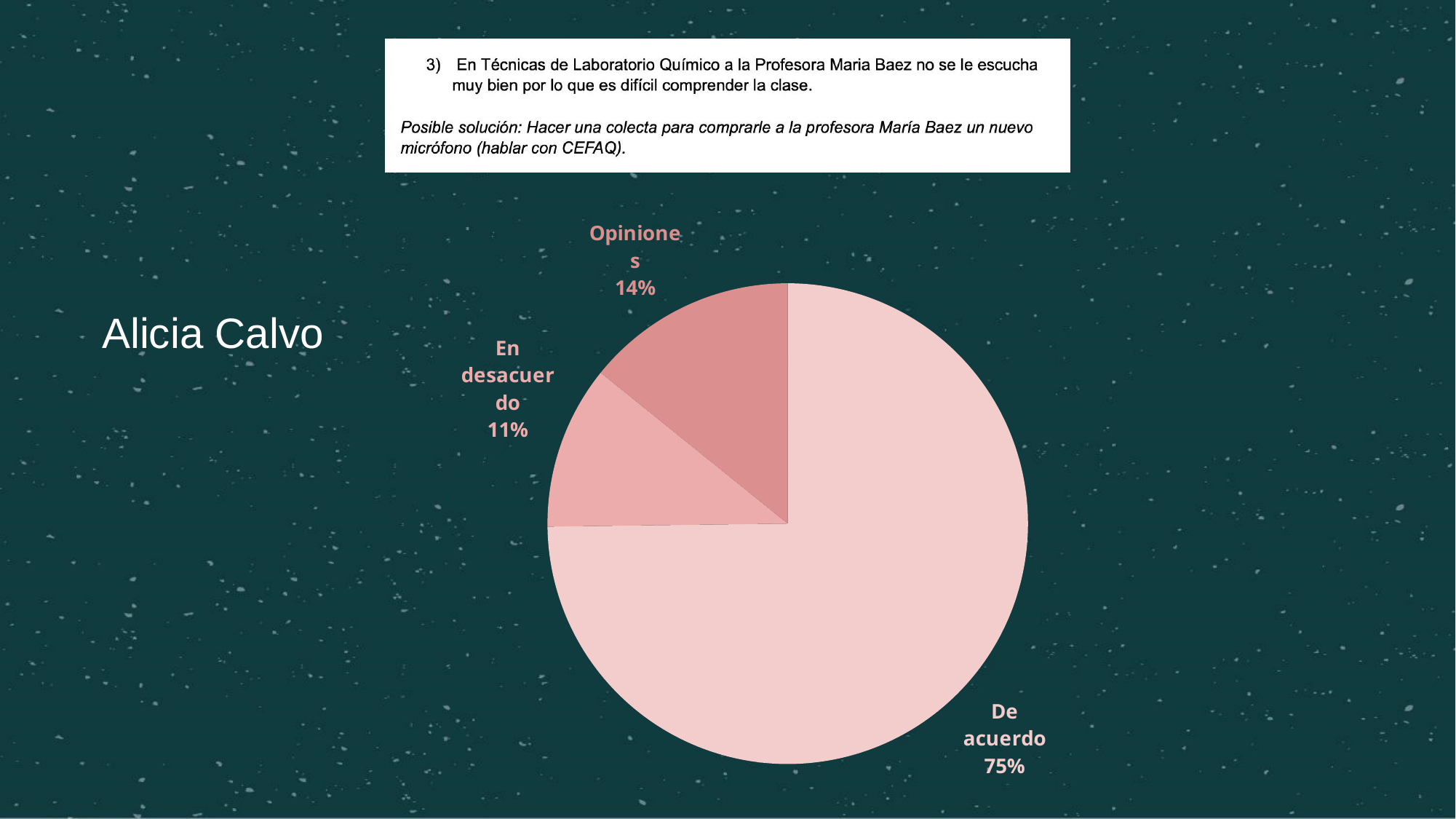
Which is larger, the "Opiniones" slice or the "En desacuerdo" slice? Opiniones What percentage of the pie is labelled "Opiniones"? 14% How many slices does the pie chart have? 3 What percentage of the pie is labelled "De acuerdo"? 75% Which slice of the pie chart is the smallest? En desacuerdo What is the difference in percentage points between "Opiniones" and "En desacuerdo"? 3 What is the difference in percentage points between "De acuerdo" and "Opiniones"? 61 What kind of chart is shown on the slide? Pie chart What share of the pie does the "De acuerdo" slice represent? 75% What percentage of the pie is labelled "En desacuerdo"? 11% What name appears to the left of the pie chart on the slide? Alicia Calvo Which slice of the pie chart is the largest? De acuerdo